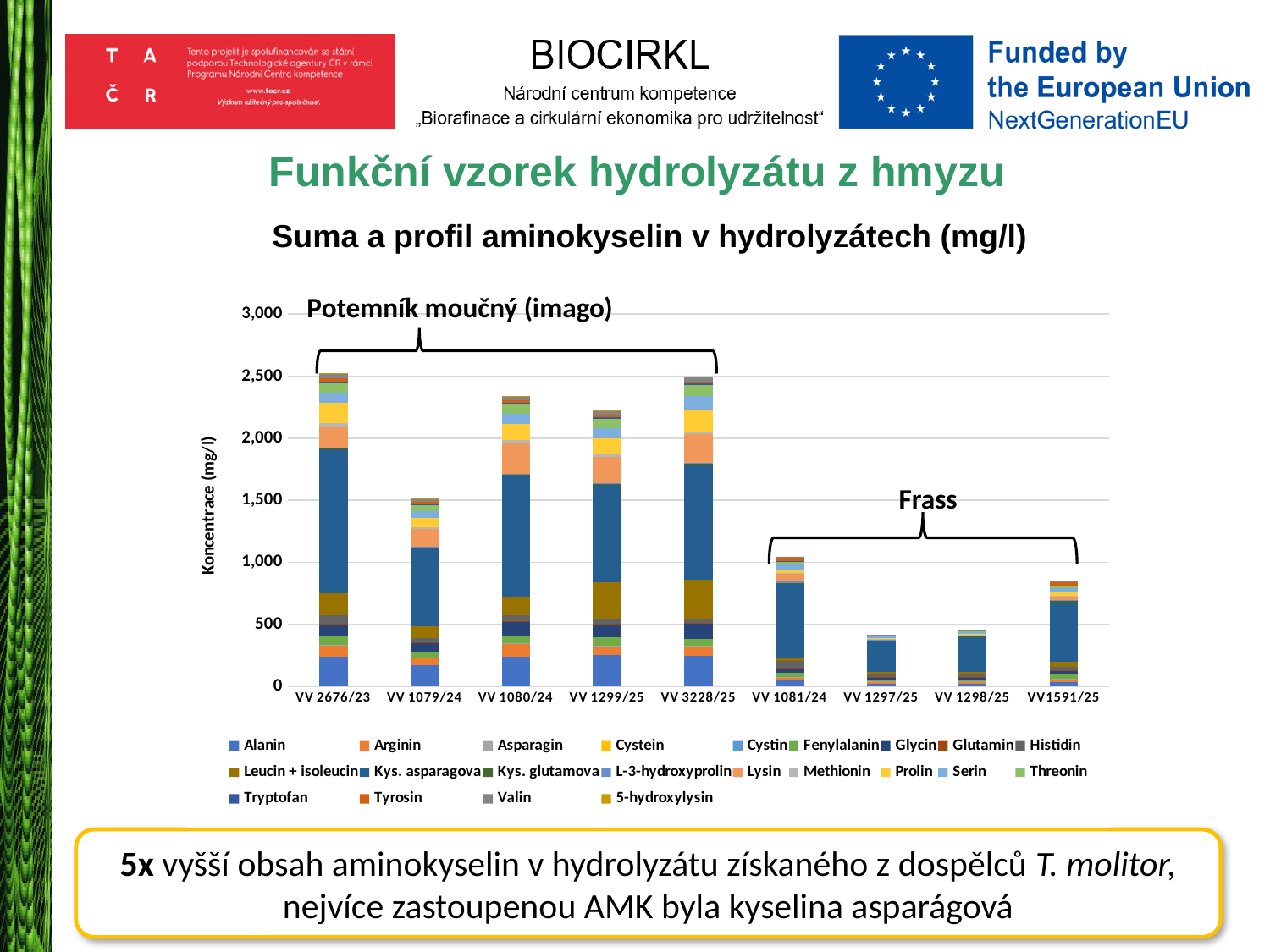
Is the total value for VV1591/25 greater or less than 1,000? less What label is given to the group of the last four bars on the chart? Frass Is the total value for VV 1297/25 greater or less than 500? less Which has the larger total value, VV 1080/24 or VV 1079/24? VV 1080/24 How many sample categories are shown on the x axis of the chart? 9 How many series does the chart legend list? 22 What is the title of the vertical axis of the chart? Koncentrace (mg/l) What kind of chart is shown on the slide? stacked bar chart Is the total value for VV 1079/24 greater or less than 1,000? greater Which has the larger total value, VV 1081/24 or VV 1298/25? VV 1081/24